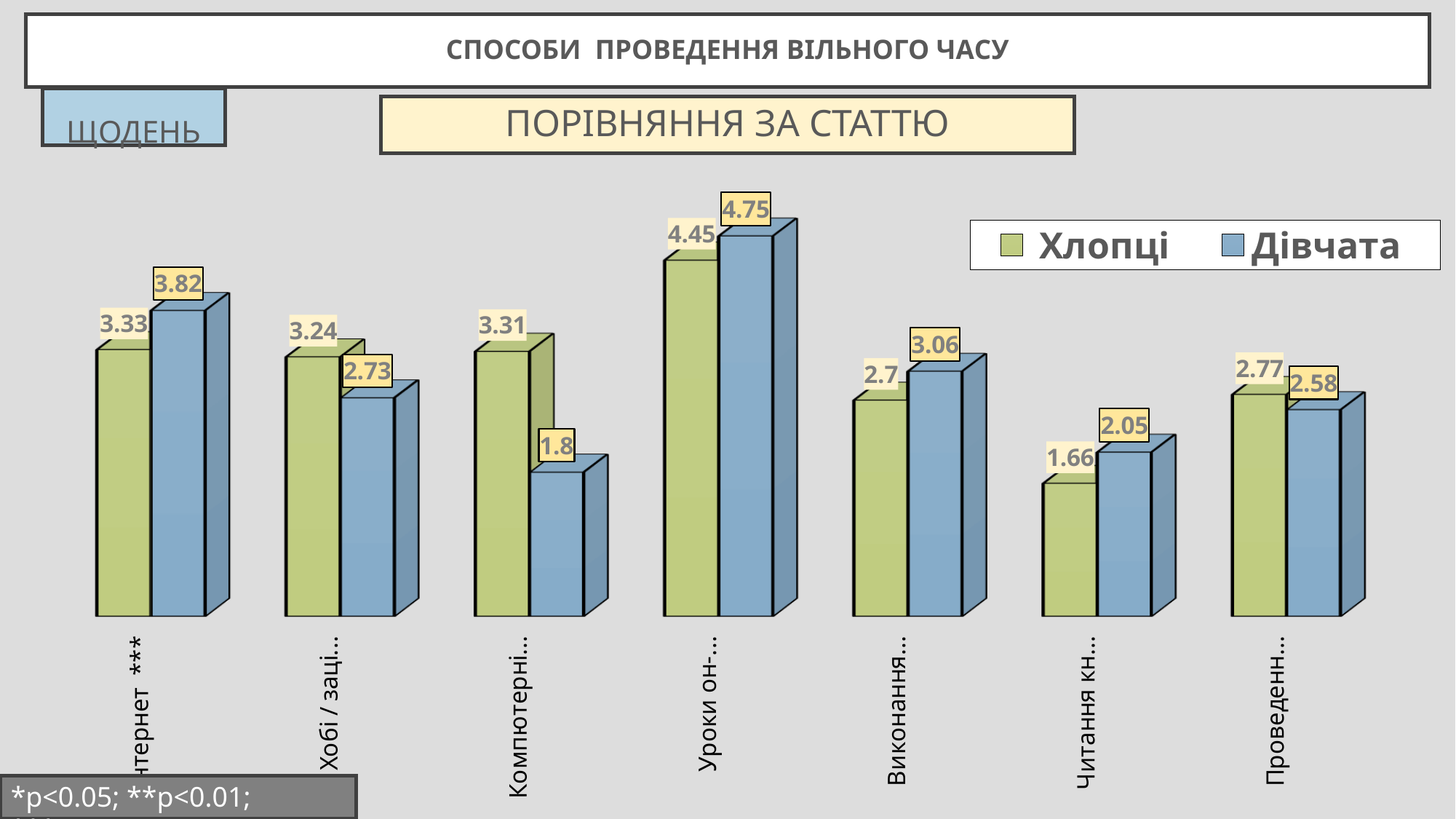
In the category beginning "Хобі", which series has the larger value, Хлопці or Дівчата? Хлопці What is the value for Хлопці in the category labelled "Інтернет"? 3.33 What is the difference between the Дівчата and Хлопці values in the category beginning "Уроки он-"? 0.3 What are the two series named in the legend? Хлопці and Дівчата What is the difference between the Хлопці and Дівчата values in the category beginning "Компютерні"? 1.51 Which category has the highest value for Дівчата? Уроки он-… What type of chart is shown on the slide? bar chart How many series does the legend list? 2 What is the value for Дівчата in the category beginning "Компютерні"? 1.8 What is the value for Дівчата in the category labelled "Інтернет"? 3.82 Which category has the lowest value for Хлопці? Читання кн… How many categories are shown on the x axis? 7